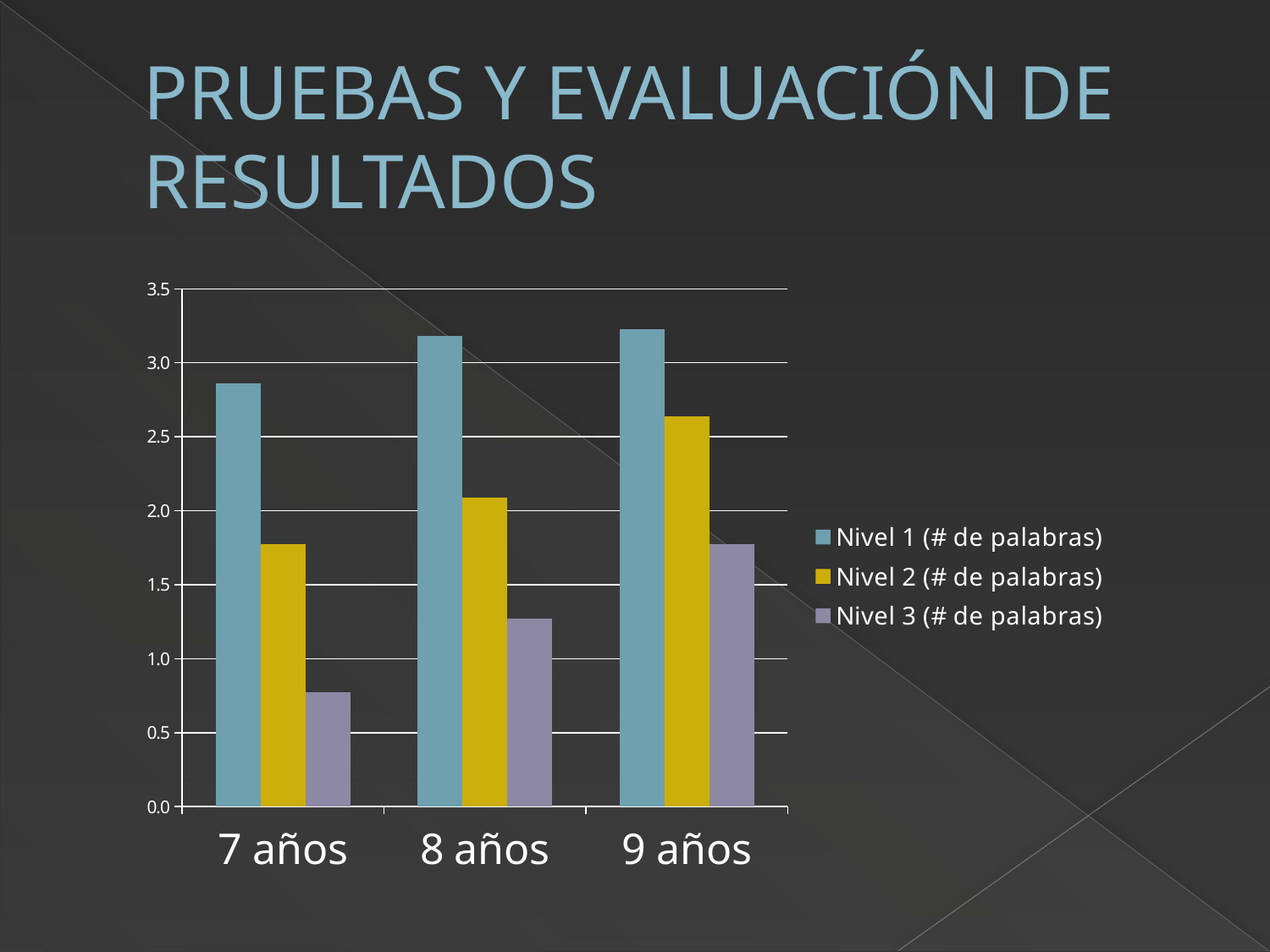
How many series does the legend list? 3 Is the value for Nivel 3 (# de palabras) at 9 años greater or less than 1.5? greater Is the value for Nivel 1 (# de palabras) at 7 años greater or less than 2.5? greater How many age categories are shown on the x axis? 3 Which is larger: Nivel 1 (# de palabras) at 7 años or Nivel 2 (# de palabras) at 9 años? Nivel 1 (# de palabras) at 7 años Is the value for Nivel 1 (# de palabras) at 8 años greater or less than 3.0? greater Do the values for Nivel 3 (# de palabras) rise or fall from 7 años to 9 años? rise For which age category is Nivel 2 (# de palabras) highest? 9 años For which age category is Nivel 3 (# de palabras) lowest? 7 años What kind of chart is shown on the slide? bar chart